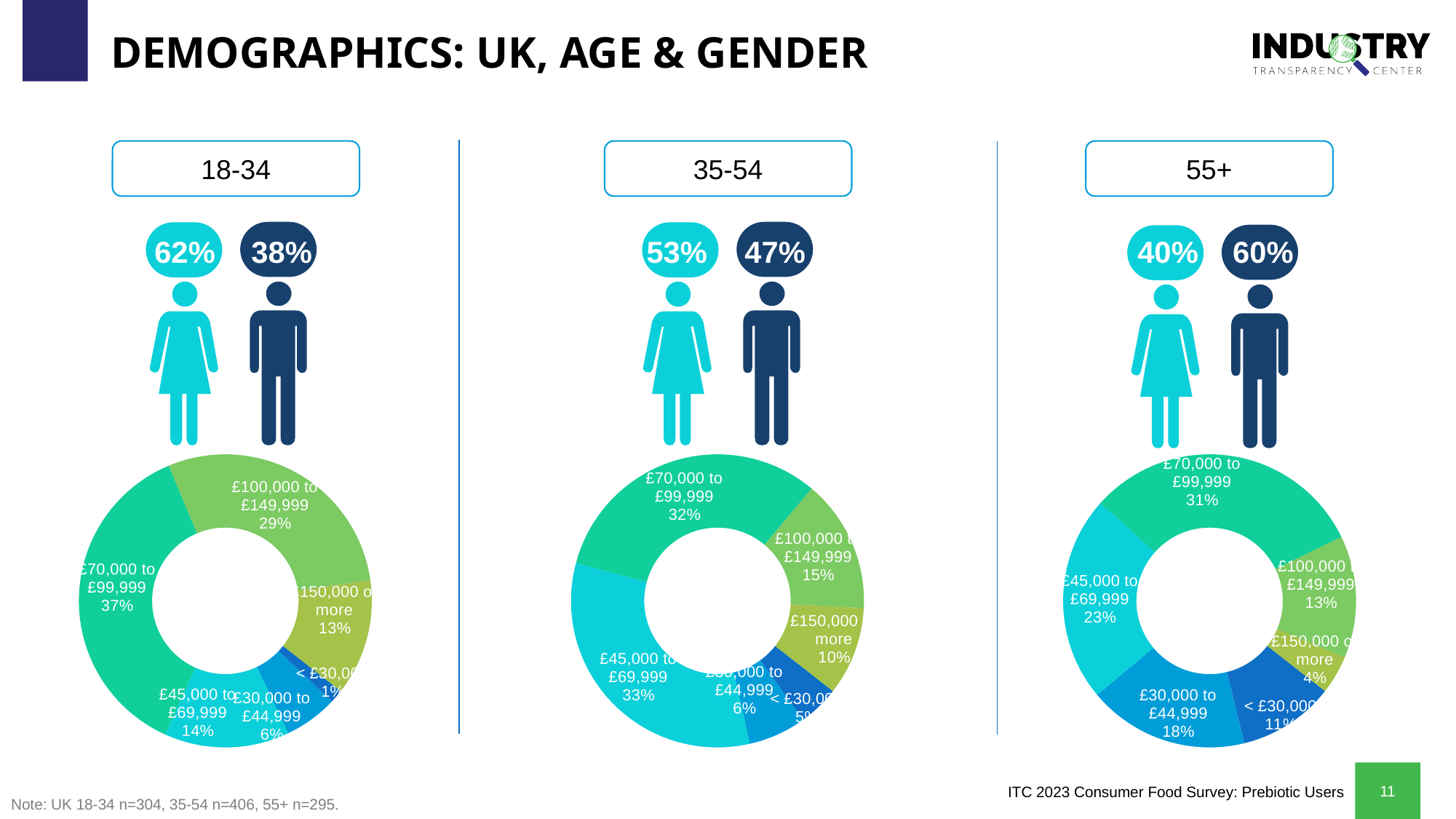
In the 35-54 donut chart, what share of respondents earn £45,000 to £69,999? 33% Which age group has the highest share of female respondents? 18-34 In the 18-34 donut chart, what share of respondents earn £70,000 to £99,999? 37% How many income bands are shown in the 55+ donut chart? 6 In the 55+ age group, what percentage of respondents are male? 60% In the 55+ donut chart, what share of respondents earn £30,000 to £44,999? 18% In the 18-34 age group, what is the difference between the female and male percentages? 24 percentage points In the 18-34 donut chart, which income band has the largest share? £70,000 to £99,999 In the 35-54 donut chart, what is the difference between the £70,000 to £99,999 share and the £100,000 to £149,999 share? 17 percentage points In the 18-34 donut chart, which is larger: the £100,000 to £149,999 share or the £45,000 to £69,999 share? £100,000 to £149,999 In the 55+ donut chart, which income band has the smallest share? £150,000 or more What kind of chart is used to show the income distribution for each age group? Donut (pie) chart